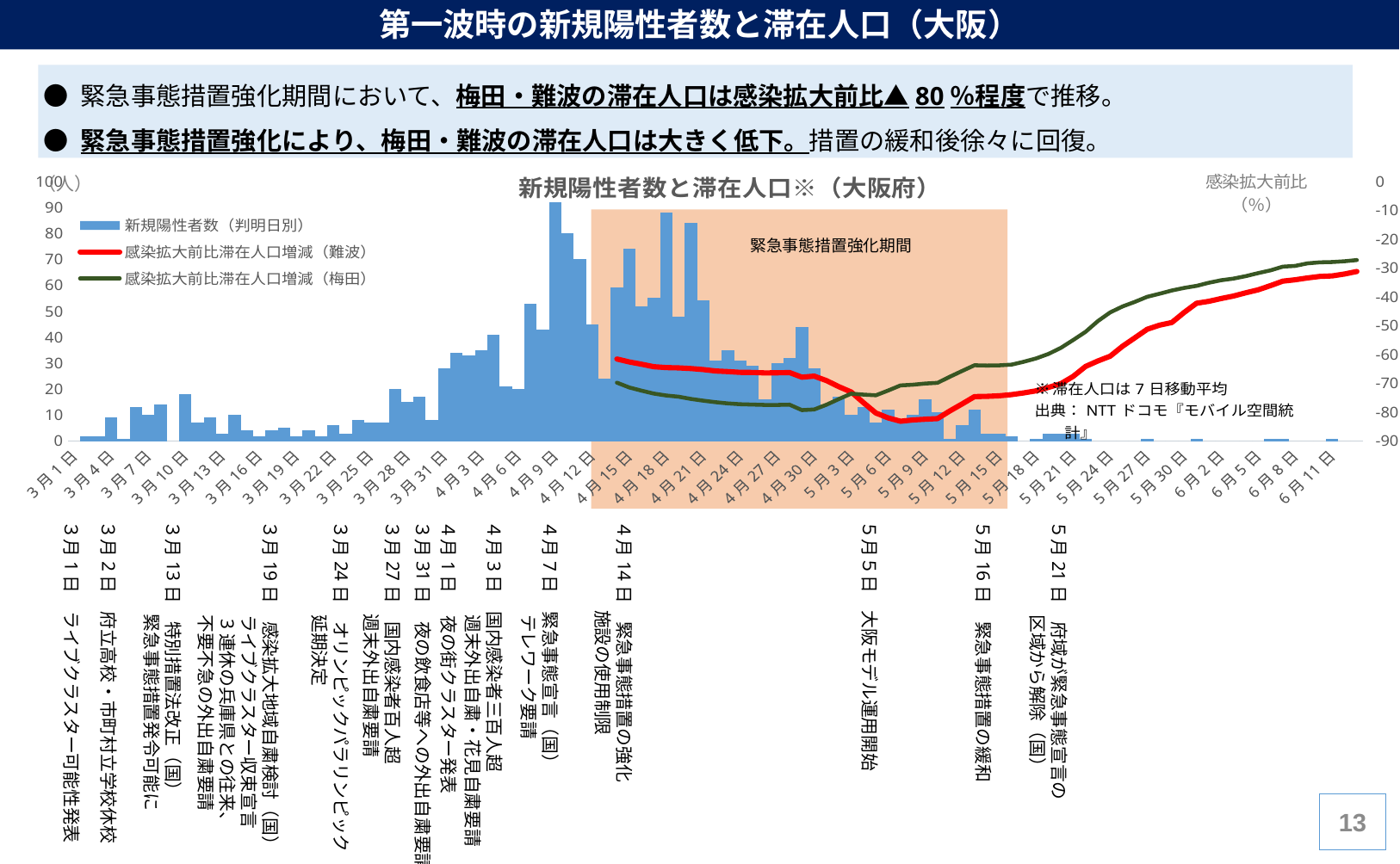
What colour is the line for 感染拡大前比滞在人口増減（難波）? Red What is the title of the chart? 新規陽性者数と滞在人口※（大阪府） Do the 新規陽性者数 bars generally rise or fall between 4月9日 and 5月16日? Fall Is the value of the 梅田 line on 6月11日 greater or less than -40 (%)? greater What kind of chart is shown on the slide? A combined bar and line chart On 6月11日, which line is higher: 梅田 or 難波? 梅田 Is the value of the 難波 line on 5月9日 greater or less than -70 (%)? less How many series does the chart legend list? 3 Is the tallest bar for 新規陽性者数 (around 4月9日) greater or less than 80? greater On 4月15日, which line is higher: 梅田 or 難波? 難波 Does the 難波 line rise or fall between 5月9日 and 6月11日? Rises